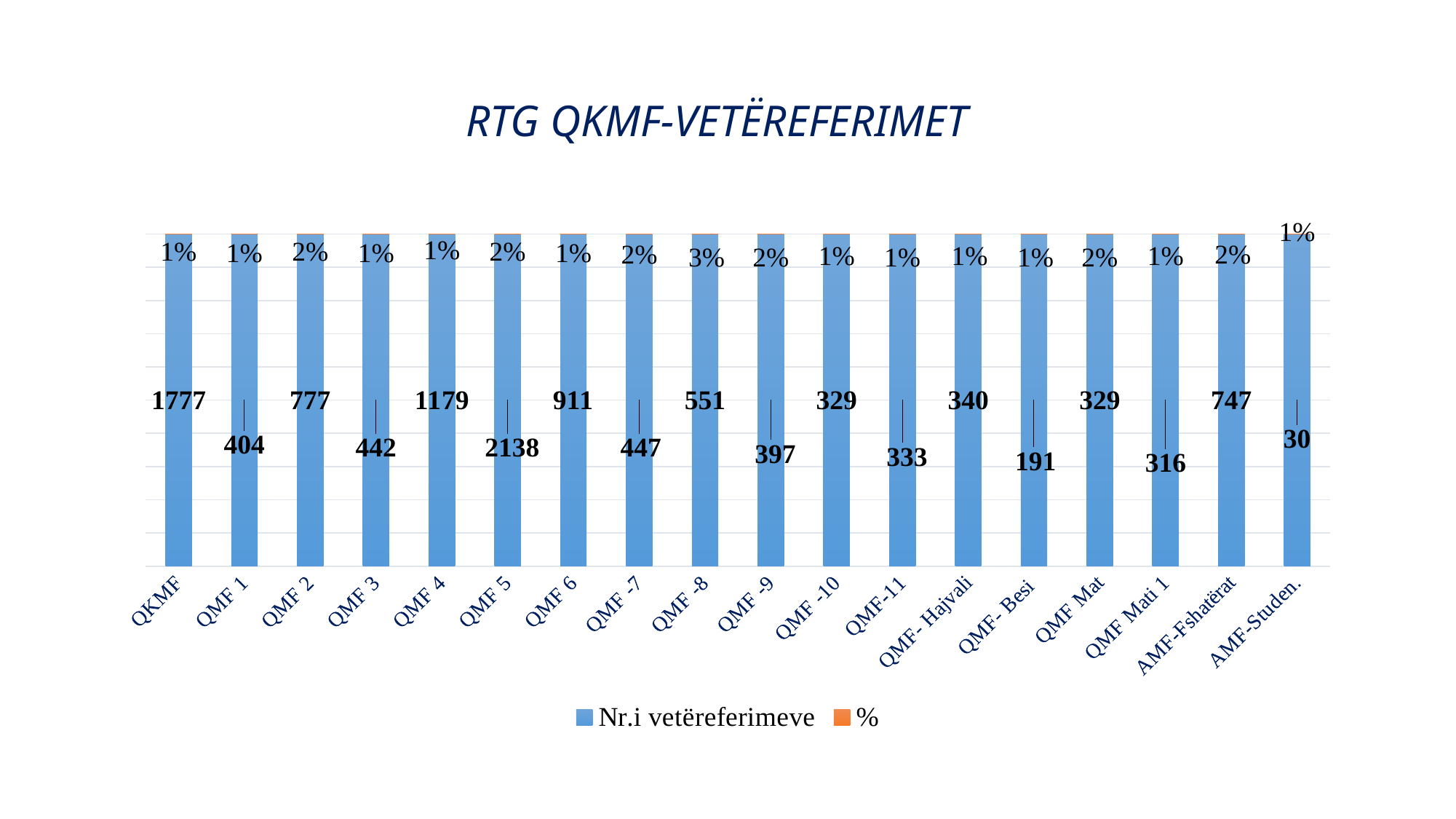
What type of chart is shown? Bar chart Which category has the highest Nr.i vetëreferimeve value according to the data labels? QMF 5 How many categories are shown on the x axis? 18 What is the difference between the Nr.i vetëreferimeve values for QMF 5 and QKMF? 361 What percentage is shown for QMF -8? 3% What is the title of the chart? RTG QKMF-VETËREFERIMET Which has a larger Nr.i vetëreferimeve value, QMF 4 or QMF 6? QMF 4 Which category has the lowest Nr.i vetëreferimeve value according to the data labels? AMF-Studen. How many series does the legend list? 2 What is the Nr.i vetëreferimeve value for QMF 5? 2138 What is the Nr.i vetëreferimeve value for QKMF? 1777 What is the Nr.i vetëreferimeve value for AMF-Fshatërat? 747